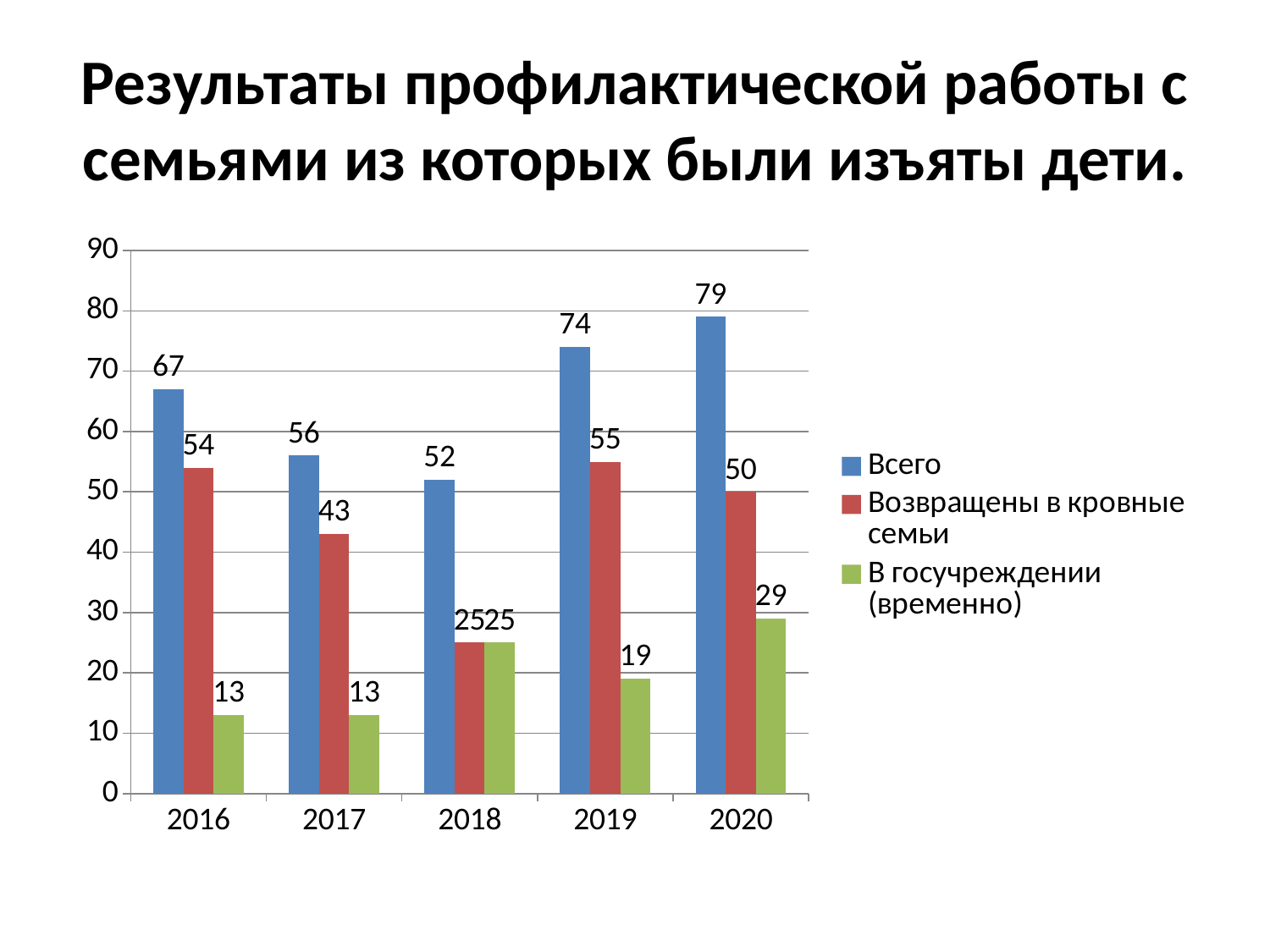
Which year has the highest value for "Всего"? 2020 Which is larger: "В госучреждении (временно)" in 2018 or in 2020? 2020 Does the value of "В госучреждении (временно)" rise or fall from 2018 to 2020? Rise What colour are the bars for the "Всего" series? Blue What is the difference between "Всего" and "Возвращены в кровные семьи" in 2016? 13 What is the value of "Всего" for 2020? 79 Which year has the lowest value for "Возвращены в кровные семьи"? 2018 What kind of chart is shown on the slide? Bar chart How many series does the legend list? 3 How many years are shown on the x axis? 5 What is the value of "В госучреждении (временно)" for 2019? 19 What is the value of "Возвращены в кровные семьи" for 2017? 43